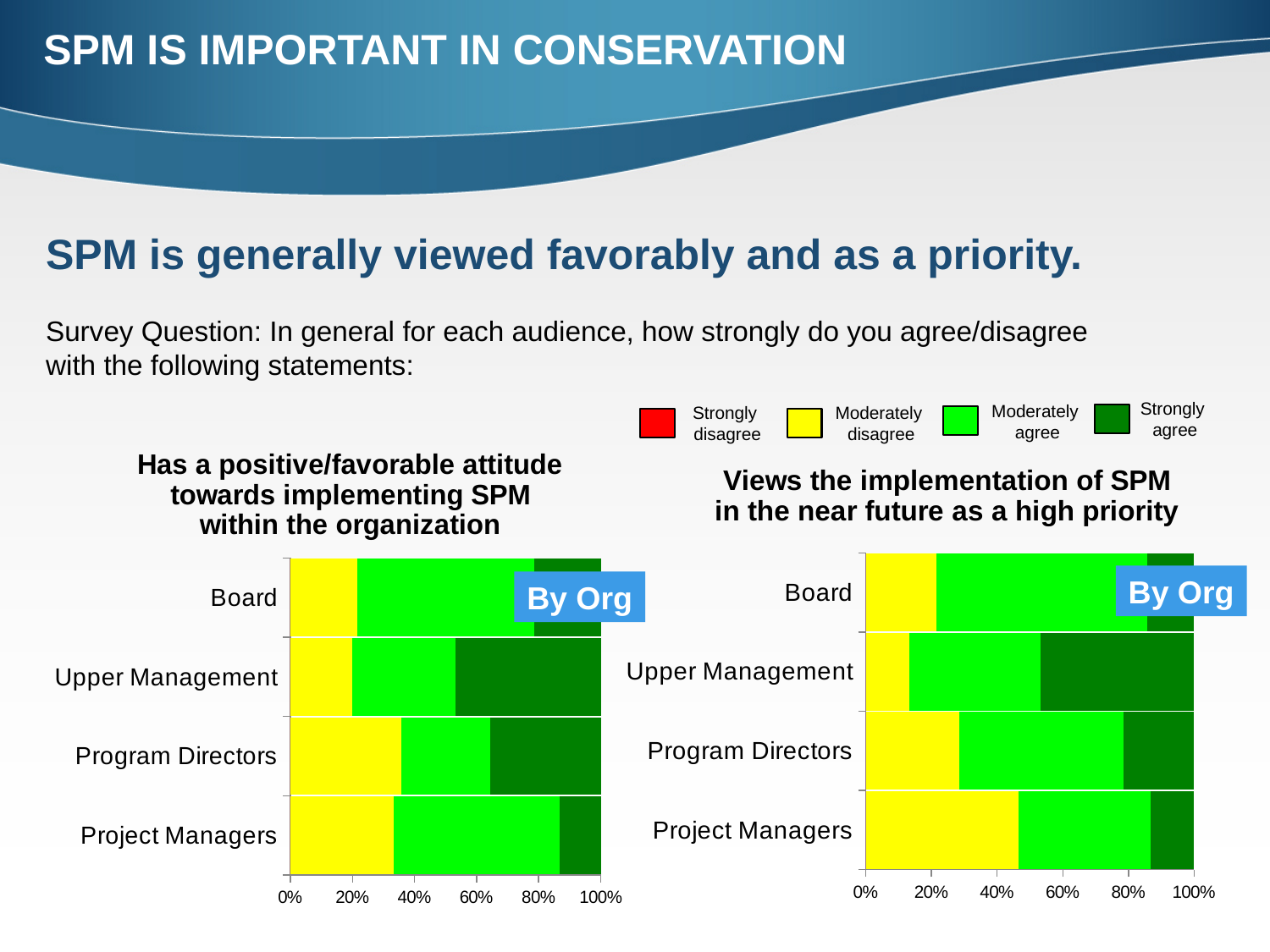
In the chart titled 'Has a positive/favorable attitude towards implementing SPM within the organization', which category has the smallest Strongly agree share? Project Managers What kind of chart is the chart titled 'Has a positive/favorable attitude towards implementing SPM within the organization'? Stacked bar chart In the chart titled 'Views the implementation of SPM in the near future as a high priority', is the Moderately disagree value for Project Managers greater or less than 40%? greater In the chart titled 'Views the implementation of SPM in the near future as a high priority', which category has the largest Strongly agree share? Upper Management Which legend entry is shown in red? Strongly disagree In the chart titled 'Has a positive/favorable attitude towards implementing SPM within the organization', which has the larger Moderately agree share, Board or Upper Management? Board What is the title of the chart on the right side of the slide? Views the implementation of SPM in the near future as a high priority How many categories are shown on the chart titled 'Views the implementation of SPM in the near future as a high priority'? 4 In the chart titled 'Has a positive/favorable attitude towards implementing SPM within the organization', which category has the largest Strongly agree share? Upper Management How many series does the shared legend list for the two charts? 4 In the chart titled 'Has a positive/favorable attitude towards implementing SPM within the organization', is the Moderately disagree value for Board greater or less than 40%? less In the chart titled 'Views the implementation of SPM in the near future as a high priority', which category has the largest Moderately disagree share? Project Managers